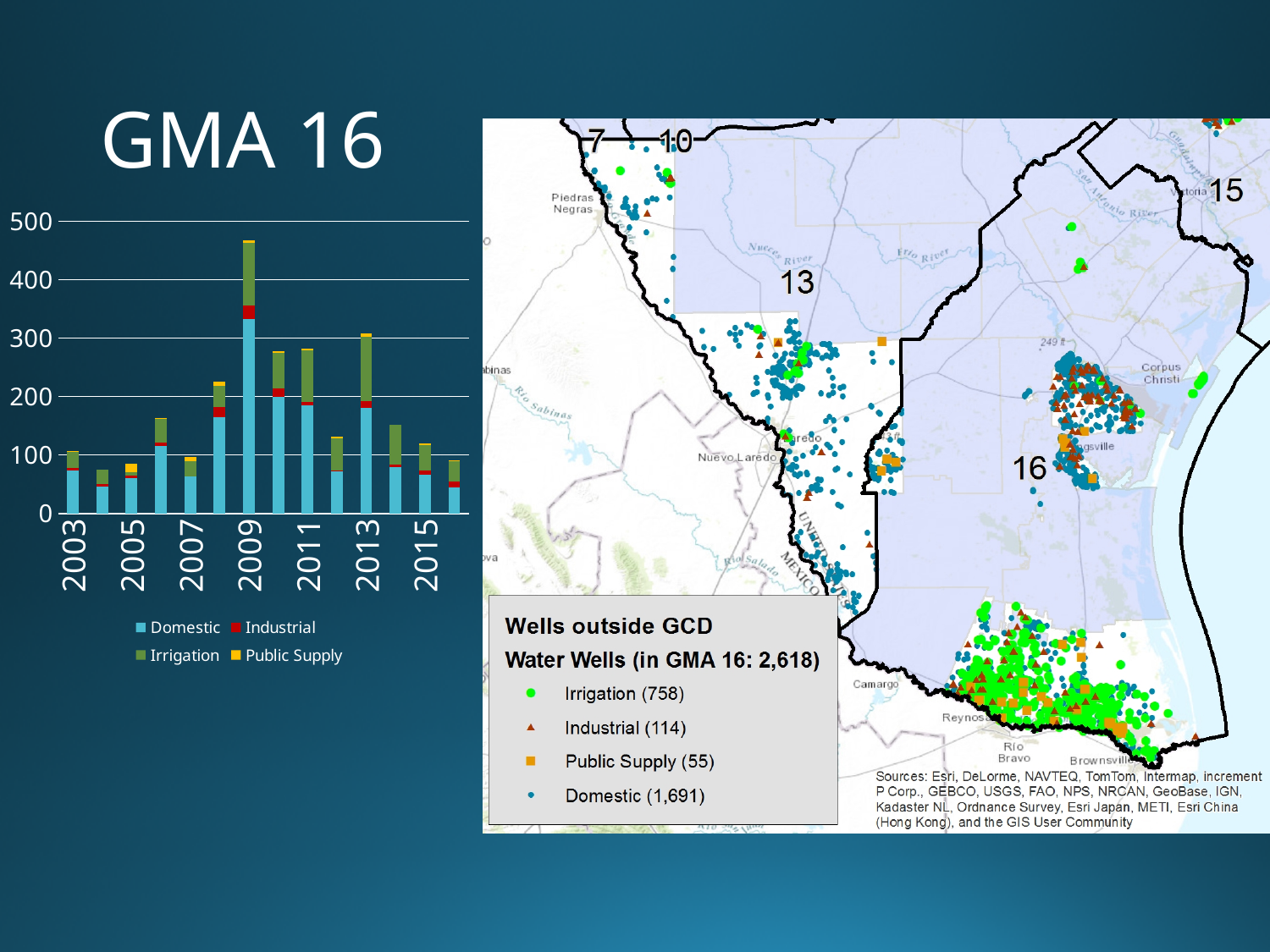
Which year has the larger total bar, 2003 or 2004? 2003 What is the title shown above the bar chart? GMA 16 What kind of chart is shown on the left of the slide? stacked bar chart Is the total bar height for 2011 greater or less than 200? greater Is the Domestic segment for 2009 greater or less than 300? greater Which year has the larger total bar, 2009 or 2013? 2009 Which year has the shortest bar in the chart? 2004 Is the total bar height for 2009 greater or less than 400? greater How many series does the legend of the bar chart list? 4 Which year has the tallest bar in the chart? 2009 How many bars (years) are plotted in the bar chart? 14